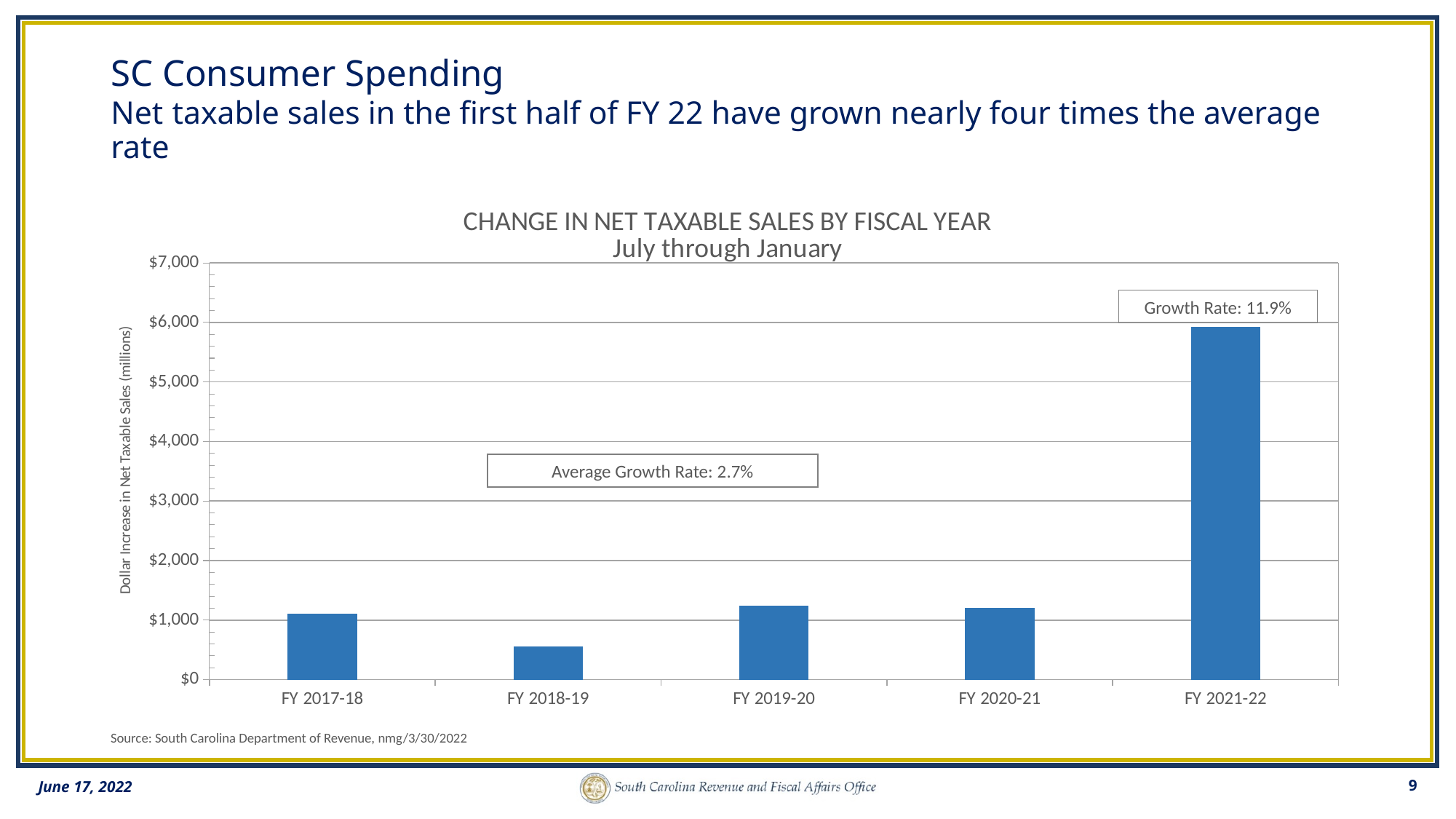
Which fiscal year has the lowest dollar increase in net taxable sales? FY 2018-19 Is the value for FY 2021-22 greater or less than $5,000? greater Is the value for FY 2019-20 greater or less than $1,000? greater Which is larger, the value for FY 2017-18 or the value for FY 2018-19? FY 2017-18 Is the value for FY 2018-19 greater or less than $1,000? less What growth rate is annotated for FY 2021-22 on the chart? 11.9% Which is larger, the value for FY 2020-21 or the value for FY 2021-22? FY 2021-22 What average growth rate is annotated on the chart? 2.7% What kind of chart is shown on the slide? Bar chart Which fiscal year has the highest dollar increase in net taxable sales? FY 2021-22 How many fiscal years are plotted on the chart? 5